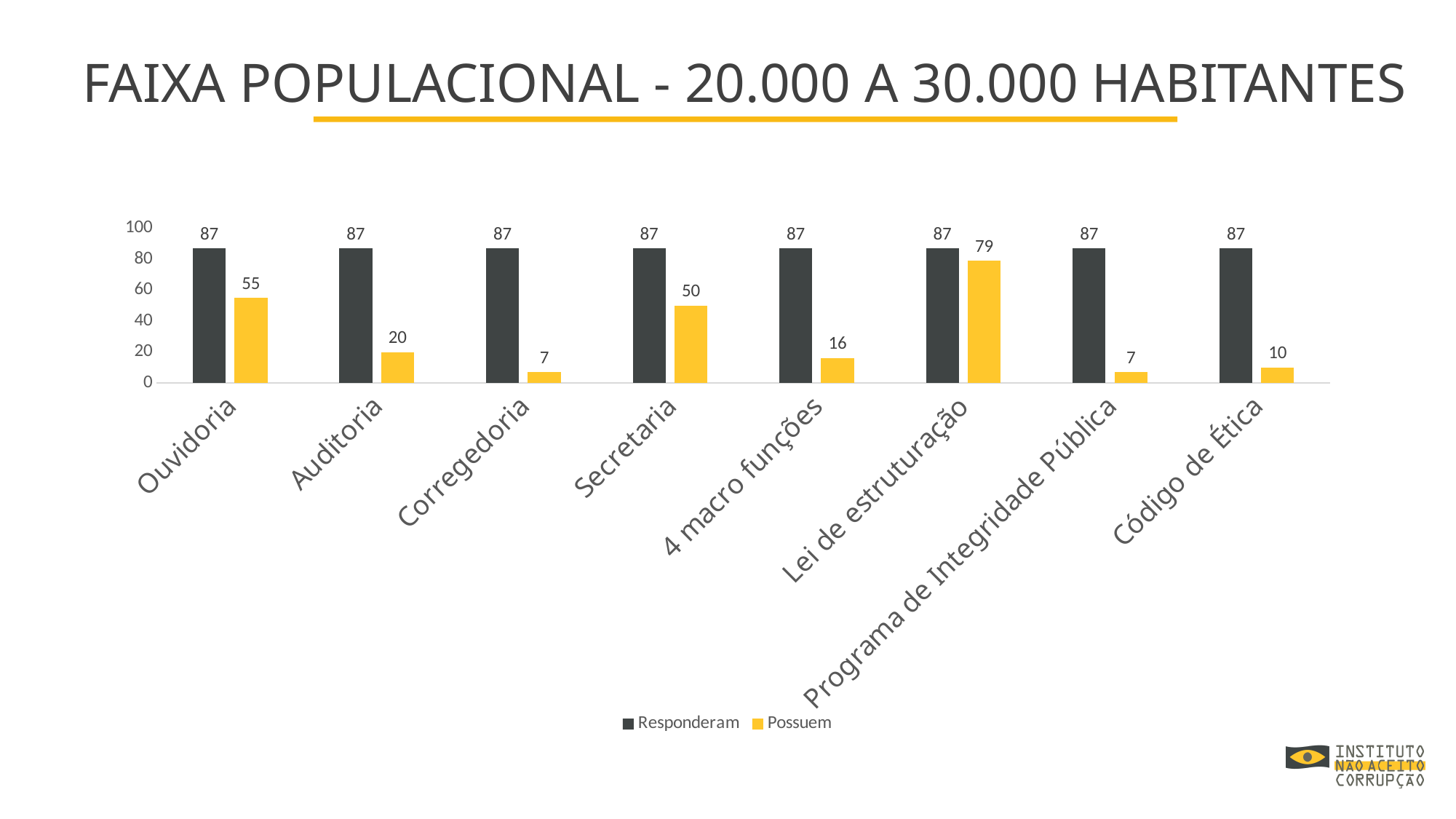
What is the value of Responderam for Secretaria? 87 What is the title of the slide? FAIXA POPULACIONAL - 20.000 A 30.000 HABITANTES What is the value of Possuem for Lei de estruturação? 79 How many categories are shown on the x axis? 8 How many series does the legend list? 2 Which category has the highest Possuem value? Lei de estruturação Which category has the lowest Possuem value? Corregedoria and Programa de Integridade Pública (7) What kind of chart is shown on the slide? bar chart What is the difference between Responderam and Possuem for Auditoria? 67 Which is larger, the Possuem value for Secretaria or for 4 macro funções? Secretaria Is the Possuem value for Código de Ética greater or less than 20? less What is the value of Possuem for Ouvidoria? 55